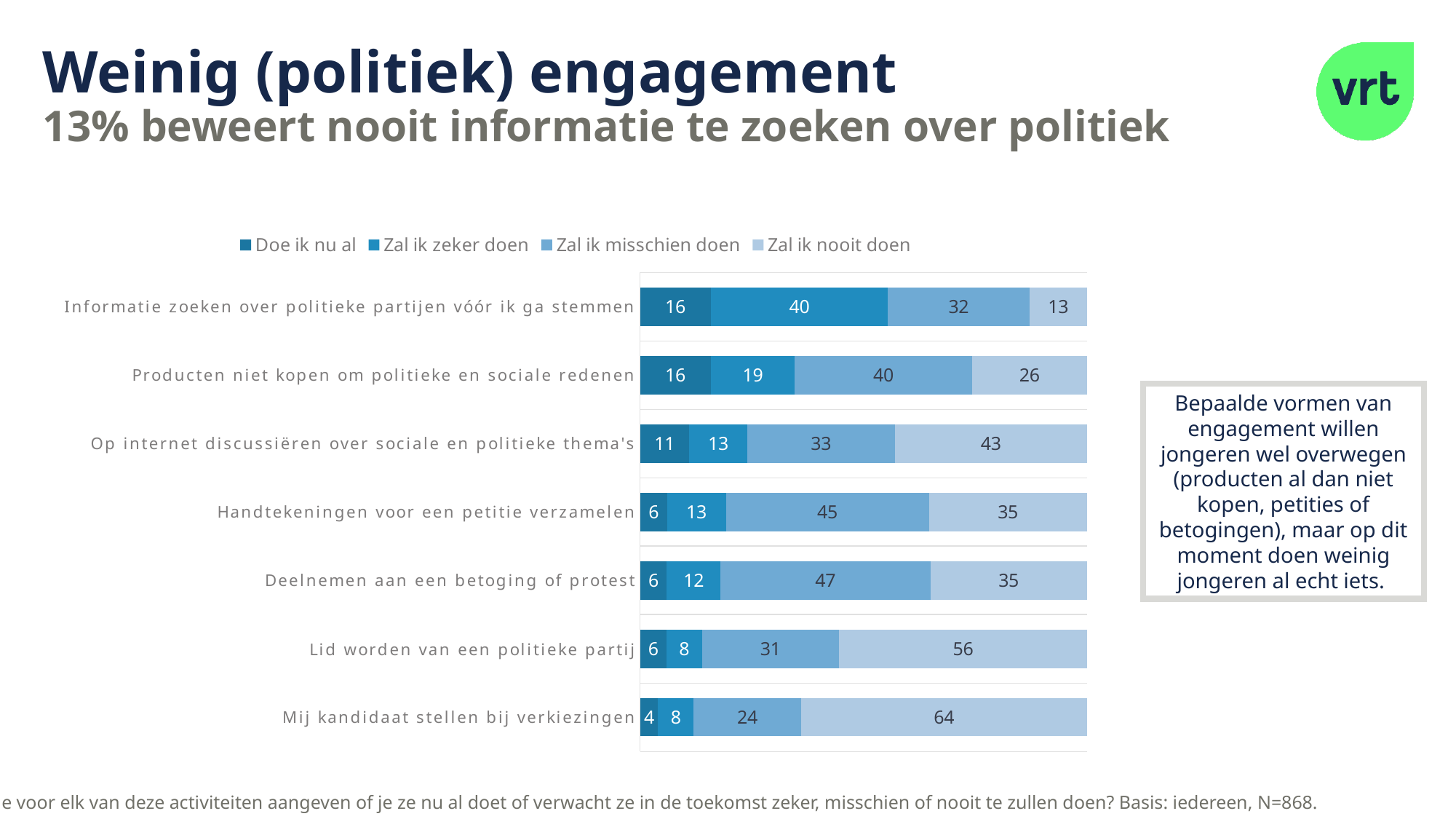
What kind of chart is shown on the slide? Stacked bar chart How many categories (activities) are shown in the chart? 7 Which category has the highest value for "Zal ik nooit doen"? Mij kandidaat stellen bij verkiezingen What is the value of "Zal ik nooit doen" for "Lid worden van een politieke partij"? 56 What is the value of "Doe ik nu al" for "Informatie zoeken over politieke partijen vóór ik ga stemmen"? 16 Which category has the lowest value for "Doe ik nu al"? Mij kandidaat stellen bij verkiezingen Which has a larger "Zal ik misschien doen" value: "Handtekeningen voor een petitie verzamelen" or "Producten niet kopen om politieke en sociale redenen"? Handtekeningen voor een petitie verzamelen How many series does the legend list? 4 What is the difference in "Zal ik nooit doen" between "Mij kandidaat stellen bij verkiezingen" and "Informatie zoeken over politieke partijen vóór ik ga stemmen"? 51 What is the first entry in the chart's legend? Doe ik nu al Which category has the highest value for "Zal ik zeker doen"? Informatie zoeken over politieke partijen vóór ik ga stemmen What is the value of "Zal ik misschien doen" for "Deelnemen aan een betoging of protest"? 47